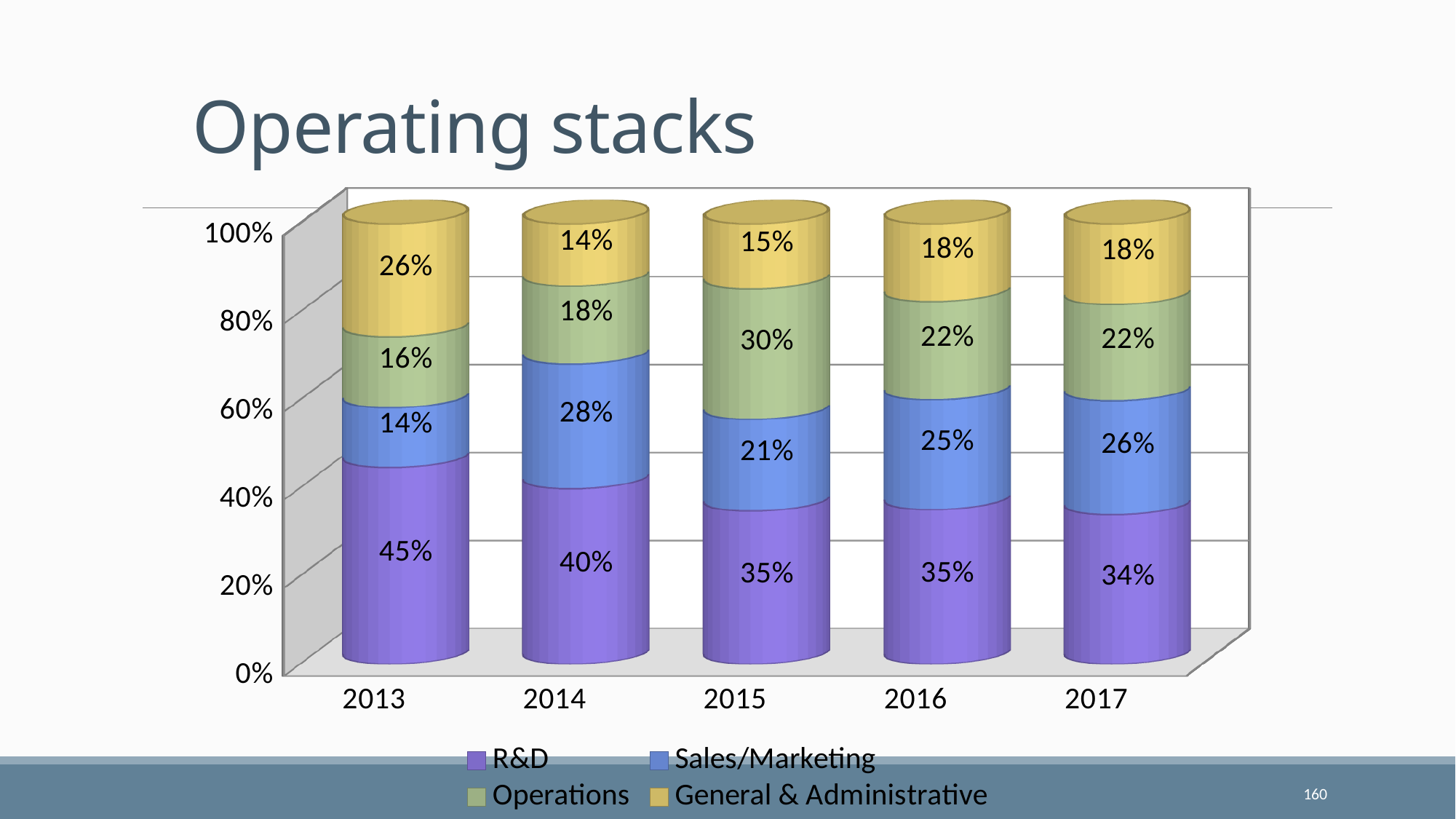
What is the General & Administrative value for 2017? 18% What is the Operations value for 2015? 30% What is the difference between the R&D value in 2013 and the R&D value in 2017? 11% How many series does the legend list? 4 What is the Sales/Marketing value for 2014? 28% What is the R&D value for 2013? 45% Does the R&D share rise or fall from 2013 to 2017? Fall In which year is the General & Administrative share lowest? 2014 How many years are shown on the x axis? 5 What kind of chart is shown on the slide? Stacked bar chart In which year is the R&D share highest? 2013 Which is larger, the Sales/Marketing value in 2015 or the Sales/Marketing value in 2016? 2016